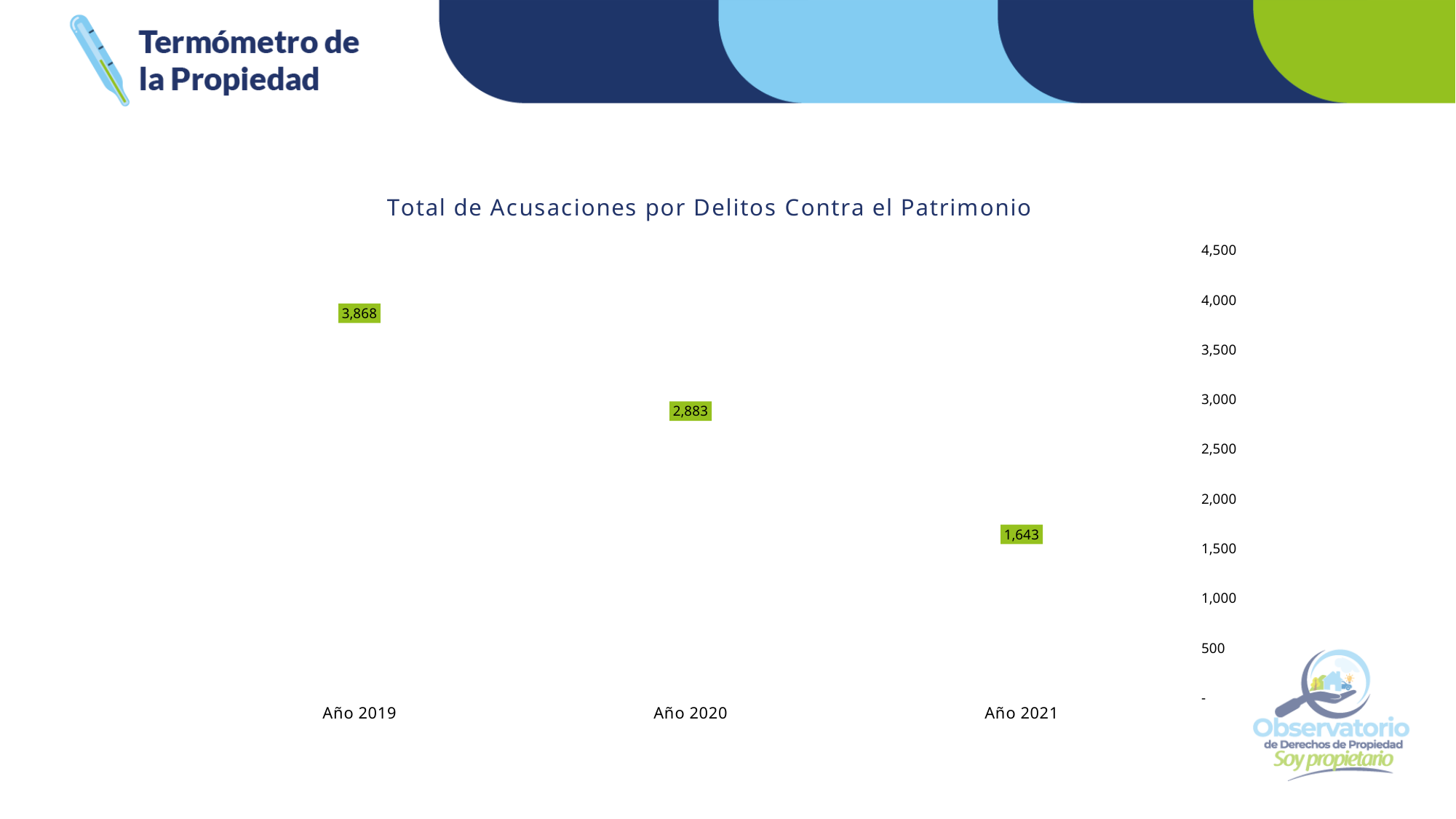
Which is larger, the value for Año 2020 or the value for Año 2021? Año 2020 What is the difference between the values for Año 2020 and Año 2021? 1,240 What is the difference between the values for Año 2019 and Año 2020? 985 What is the value for Año 2020? 2,883 What is the value for Año 2021? 1,643 What is the title of the chart? Total de Acusaciones por Delitos Contra el Patrimonio How many years are shown on the x axis? 3 Which year has the lowest value? Año 2021 Is the value for Año 2019 greater or less than 3,500? greater Which year has the highest value? Año 2019 Do the values rise or fall from Año 2019 to Año 2021? fall What is the value for Año 2019? 3,868